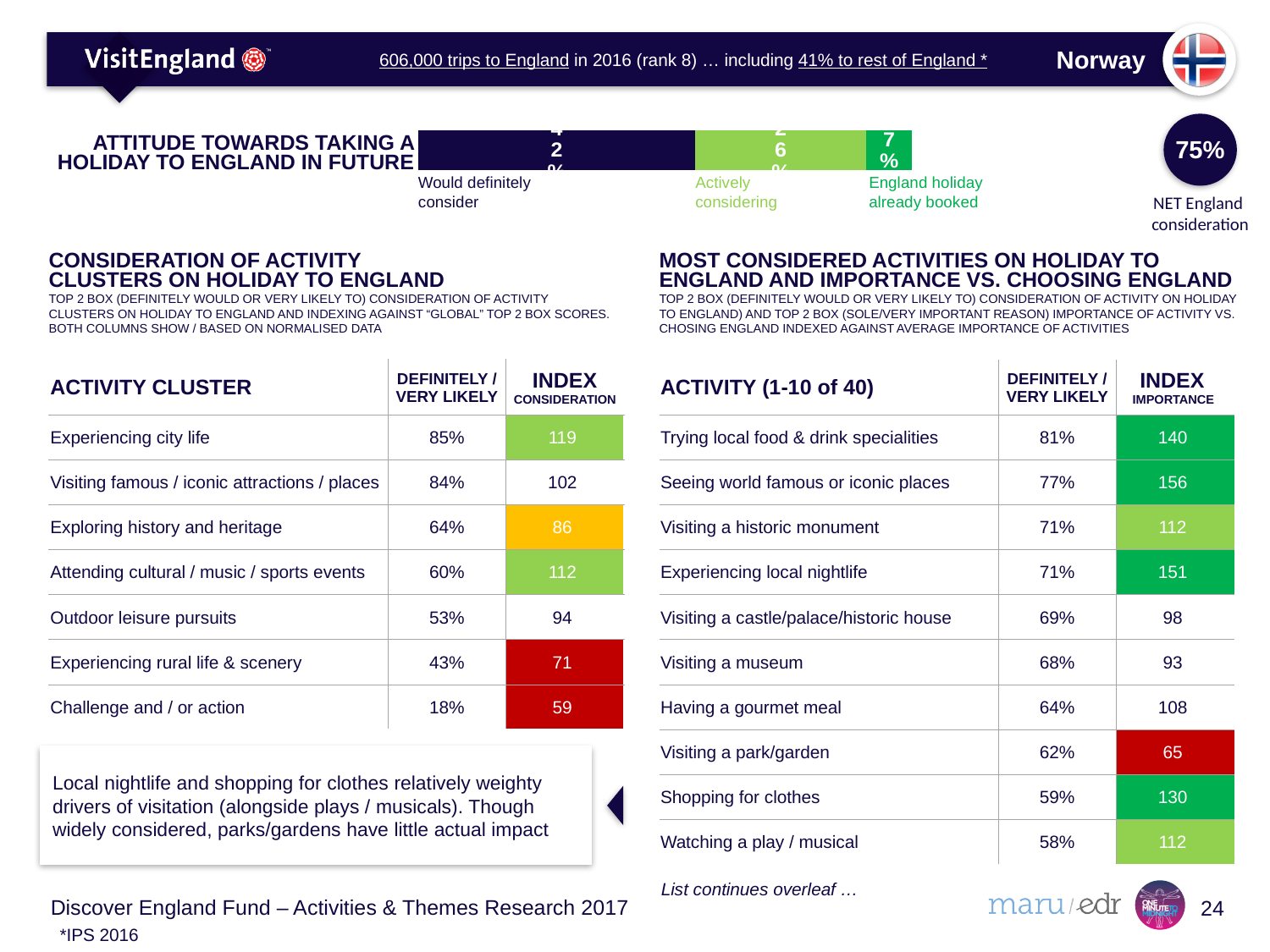
What kind of chart is shown under 'Attitude towards taking a holiday to England in future'? bar chart In the 'Attitude towards taking a holiday to England in future' chart, what percentage have an England holiday already booked? 7% How many segments make up the bar in the 'Attitude towards taking a holiday to England in future' chart? 3 In the 'Attitude towards taking a holiday to England in future' chart, which is larger: 'Would definitely consider' or 'Actively considering'? Would definitely consider In the 'Attitude towards taking a holiday to England in future' chart, what colour is the 'Would definitely consider' segment? dark navy blue In the 'Attitude towards taking a holiday to England in future' chart, which segment is the largest? Would definitely consider In the 'Attitude towards taking a holiday to England in future' chart, what is the difference between 'Actively considering' and 'England holiday already booked'? 19% In the 'Attitude towards taking a holiday to England in future' chart, what percentage are actively considering a holiday to England? 26% In the 'Attitude towards taking a holiday to England in future' chart, what percentage would definitely consider a holiday to England? 42% In the 'Attitude towards taking a holiday to England in future' chart, what is the NET England consideration figure? 75% In the 'Attitude towards taking a holiday to England in future' chart, which segment is the smallest? England holiday already booked In the 'Attitude towards taking a holiday to England in future' chart, what is the total of the three segments of the stacked bar? 75%